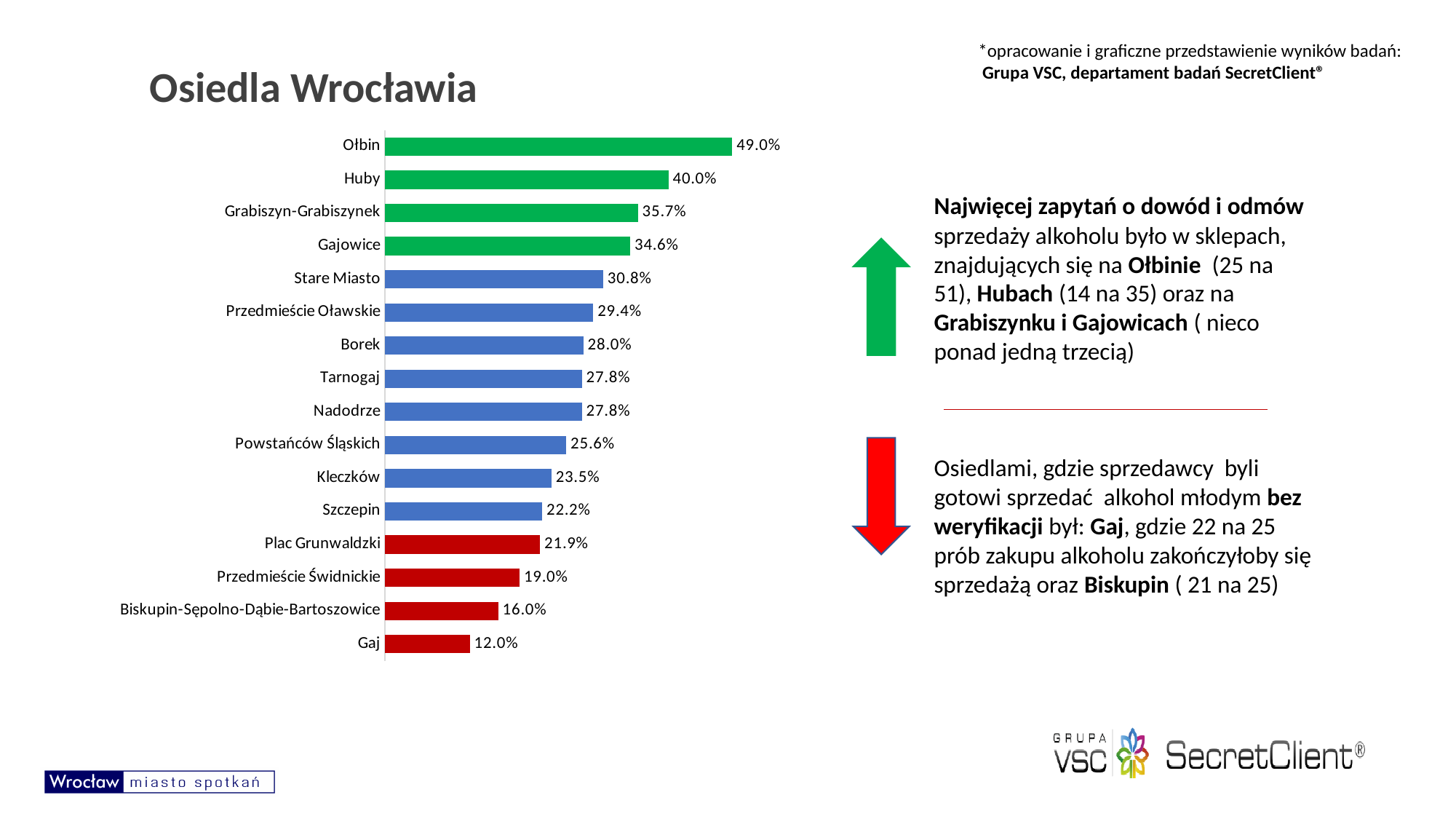
Which has a larger value, Borek or Kleczków? Borek What is the difference between the values for Ołbin and Huby? 9.0% What is the difference between the values for Gajowice and Gaj? 22.6% Which district has the lowest value? Gaj What is the value for Ołbin? 49.0% Which has a larger value, Szczepin or Przedmieście Świdnickie? Szczepin What colour are the bars for the four districts with the highest values? Green Which district has the highest value? Ołbin What kind of chart is shown on the slide? Bar chart What is the value for Stare Miasto? 30.8% How many districts are shown in the chart? 16 What is the value for Biskupin-Sępolno-Dąbie-Bartoszowice? 16.0%